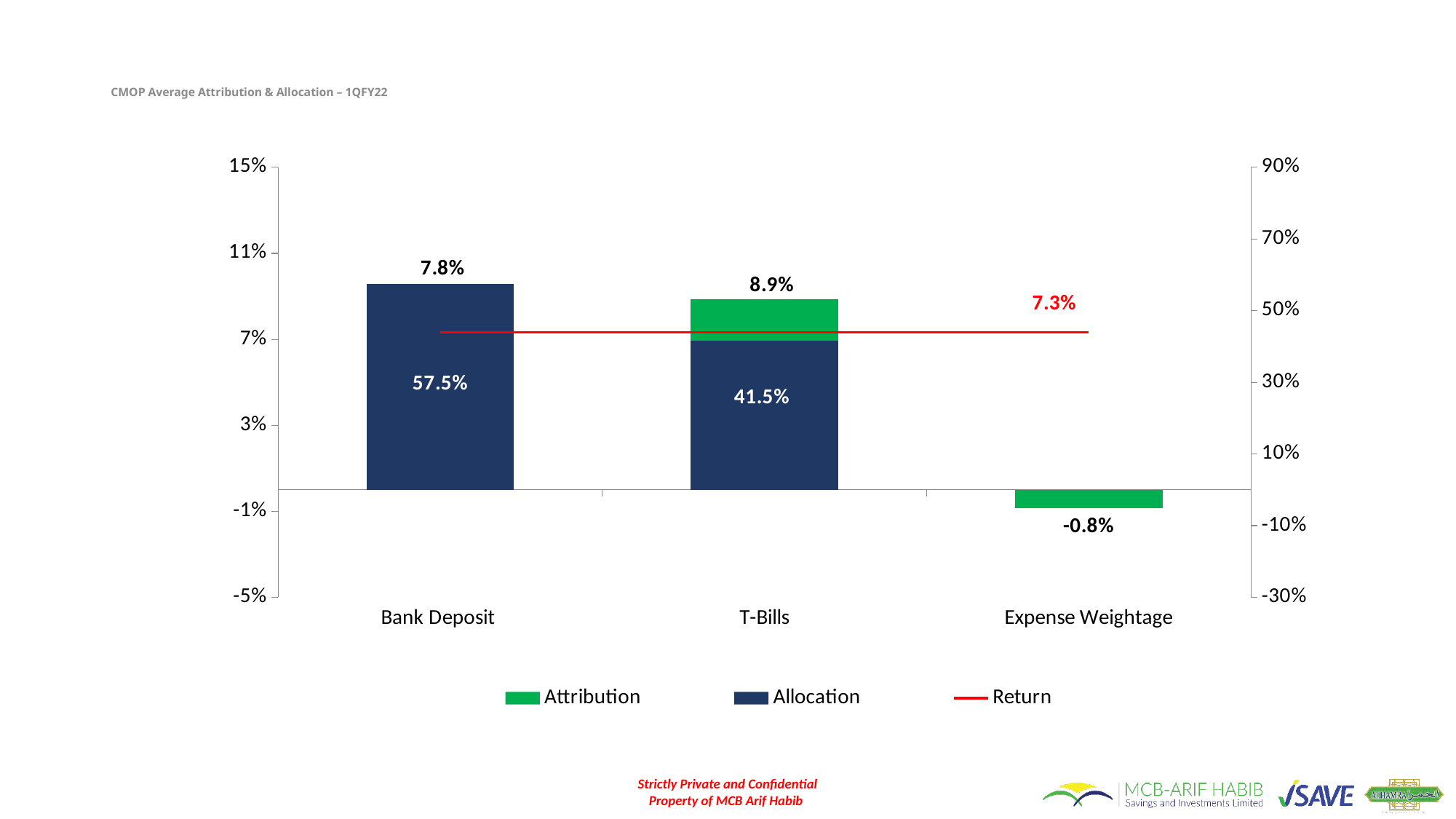
What is the Attribution value for Bank Deposit? 7.8% What is the Attribution value for Expense Weightage? -0.8% What is the Allocation value for T-Bills? 41.5% What is the difference between the Allocation values for Bank Deposit and T-Bills? 16.0% Which category has the highest Attribution value? T-Bills How many series does the legend list? 3 What is the Attribution value for T-Bills? 8.9% Which is larger, the Attribution for T-Bills or the Attribution for Bank Deposit? T-Bills What is the Allocation value for Bank Deposit? 57.5% How many categories are shown on the x axis? 3 What value is labelled on the Return line? 7.3% Which category has the lowest Attribution value? Expense Weightage